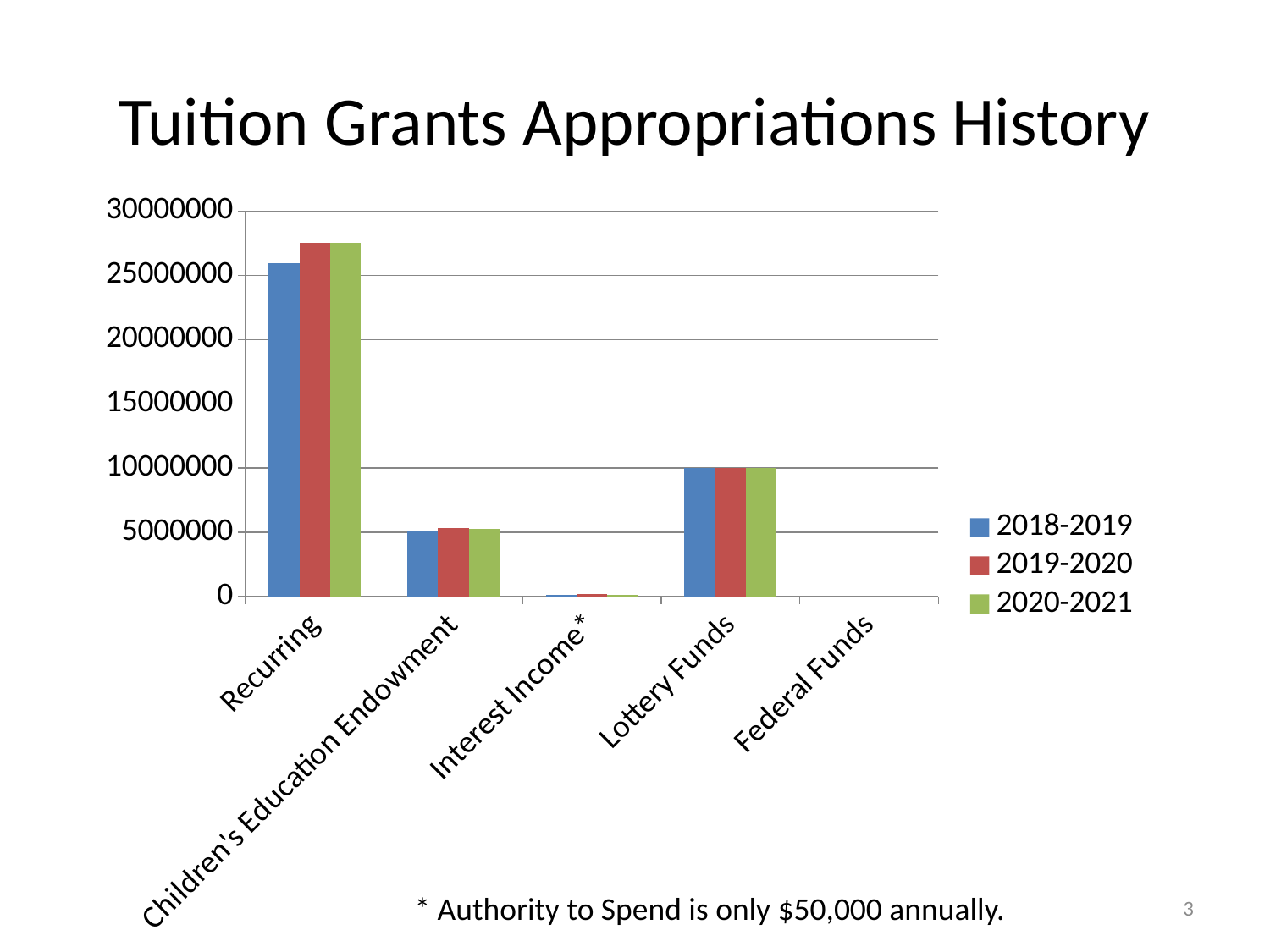
Which legend entry is shown in green? 2020-2021 Is the 2019-2020 value for Recurring greater or less than 25000000? greater How many series does the legend list? 3 What kind of chart is shown on the slide? bar chart What is the title of the chart? Tuition Grants Appropriations History Which is larger for Recurring: the 2018-2019 value or the 2019-2020 value? 2019-2020 Which category has the lowest values across all three years? Federal Funds How many categories are shown on the x axis? 5 Which is larger for 2018-2019: Recurring or Lottery Funds? Recurring Which category has the highest values across all three years? Recurring Is the 2018-2019 value for Interest Income* greater or less than 5000000? less Is the 2020-2021 value for Children's Education Endowment greater or less than 10000000? less